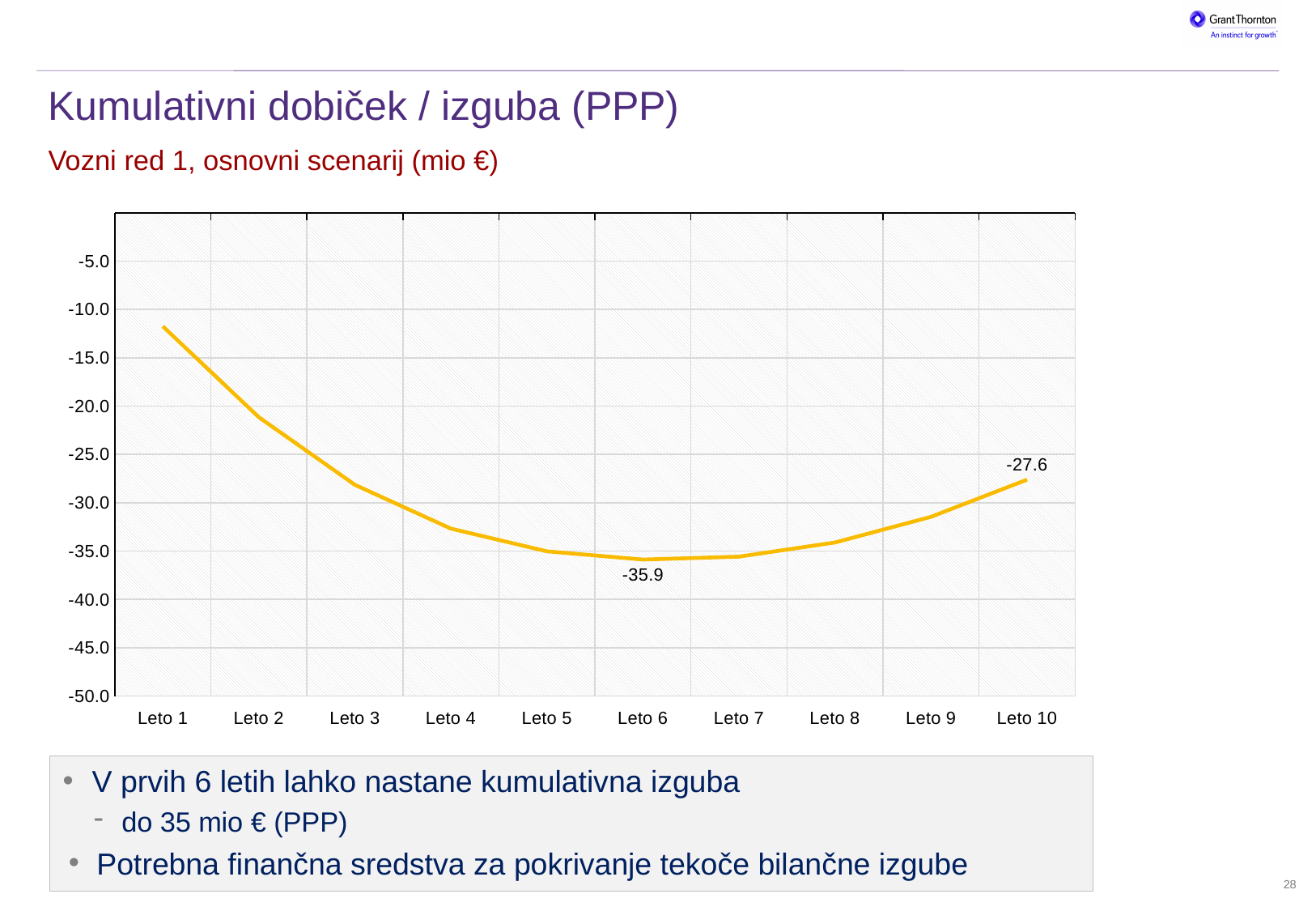
What is the value for Leto 10? -27.6 What is the difference between the values for Leto 10 and Leto 6? 8.3 How many years are shown on the x axis? 10 Which year has the highest value on the chart? Leto 1 Is the value for Leto 4 greater or less than -30.0? less Which year has the lowest value on the chart? Leto 6 What kind of chart is shown on the slide? line chart Is the value for Leto 3 greater or less than -25.0? less What is the value for Leto 6? -35.9 Is the value for Leto 1 greater or less than -15.0? greater Which is larger, the value for Leto 1 or the value for Leto 10? Leto 1 Do the values rise or fall from Leto 1 to Leto 6? fall